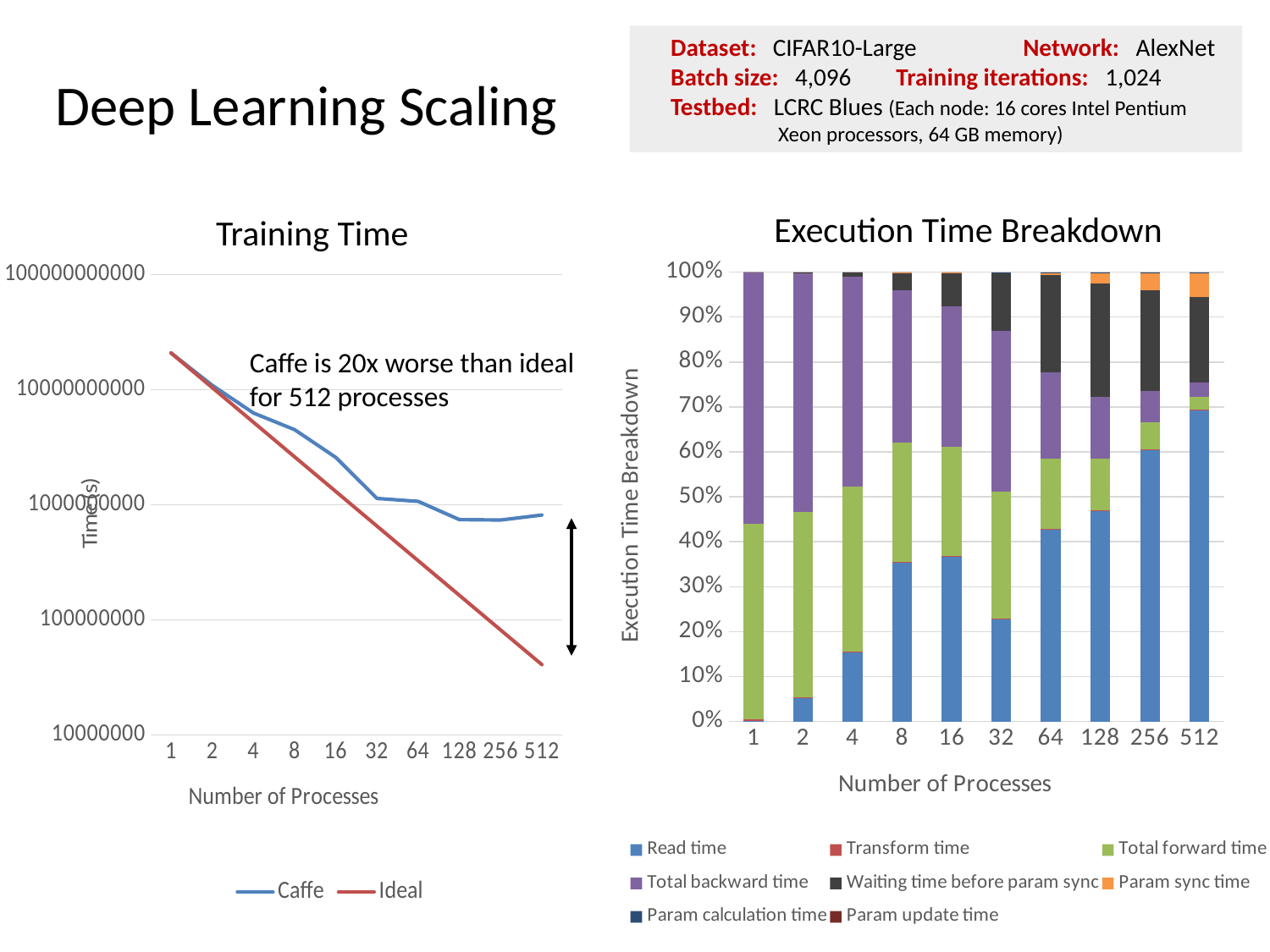
In the "Execution Time Breakdown" chart, is the Read time share at 512 processes greater or less than 60%? greater How many process counts are shown on the x axis of the "Execution Time Breakdown" chart? 10 How many series does the legend of the "Training Time" chart list? 2 What kind of chart is the "Execution Time Breakdown" chart? bar chart In the "Execution Time Breakdown" chart, which number of processes has the largest Read time share? 512 What is the x-axis label of the "Execution Time Breakdown" chart? Number of Processes In the "Execution Time Breakdown" chart, does the Read time share rise or fall as the number of processes increases? rise How many series does the legend of the "Execution Time Breakdown" chart list? 8 In the "Training Time" chart, at 512 processes, which series has the larger value, Caffe or Ideal? Caffe In the "Training Time" chart, is the Ideal value at 512 processes greater or less than 100000000? less In the "Training Time" chart, does the Caffe line rise or fall as the number of processes increases? fall What kind of chart is the "Training Time" chart? line chart